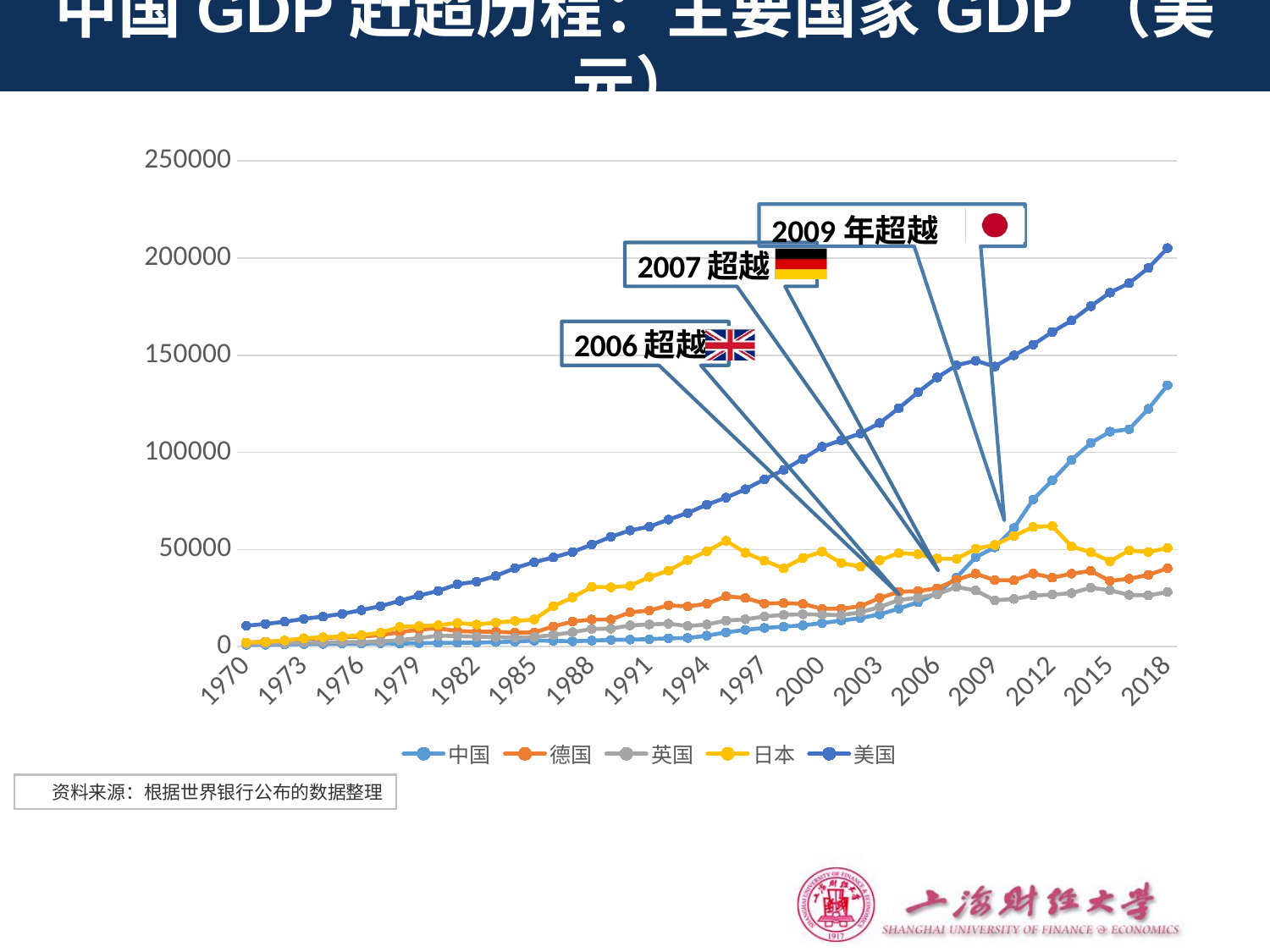
What kind of chart is shown on the slide? line chart Is the value for 中国 in 2018 greater or less than 100000? greater Which country has the lowest GDP in 2018? 英国 In 2018, which is larger, the GDP of 中国 or 日本? 中国 Does the GDP of 美国 generally rise or fall from 1970 to 2018? rise Is the value for 日本 in 2018 greater or less than 100000? less Which country has the highest GDP in 2018? 美国 According to the annotation, in which year did China overtake the United Kingdom? 2006 According to the annotation, in which year did China overtake Japan? 2009 Is the value for 美国 in 2018 greater or less than 200000? greater How many series does the legend list? 5